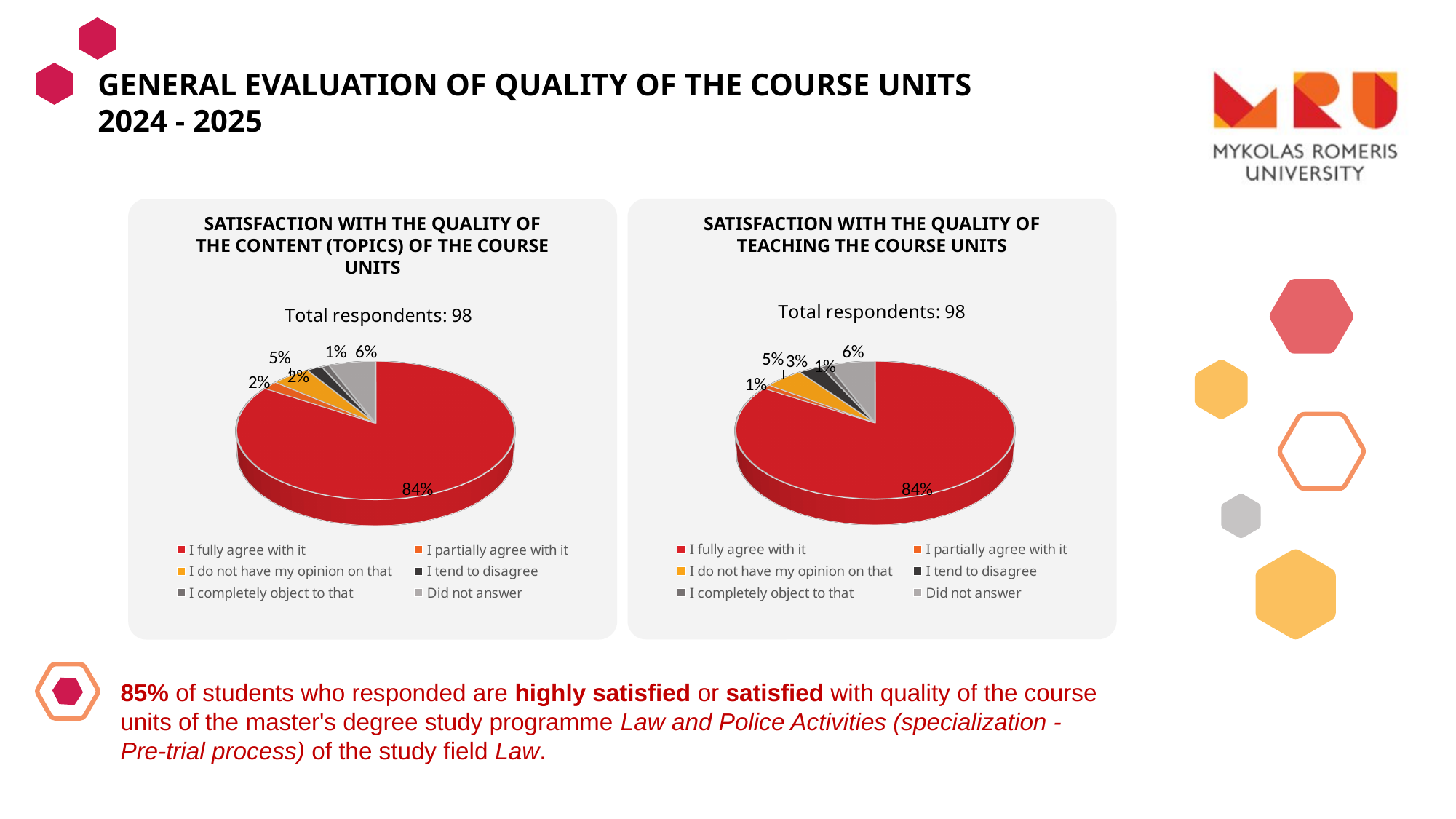
How many response categories does the legend of the 'Satisfaction with the quality of teaching the course units' chart list? 6 In the 'Satisfaction with the quality of the content (topics) of the course units' chart, what share of respondents chose 'I fully agree with it'? 84% What kind of chart is used in the 'Satisfaction with the quality of the content (topics) of the course units' panel? Pie chart In the 'Satisfaction with the quality of the content (topics) of the course units' chart, what percentage is shown for 'Did not answer'? 6% In the 'Satisfaction with the quality of teaching the course units' chart, what percentage is shown for 'I tend to disagree'? 3% In the 'Satisfaction with the quality of teaching the course units' chart, which is larger: 'Did not answer' or 'I tend to disagree'? Did not answer How many total respondents are reported for the 'Satisfaction with the quality of teaching the course units' chart? 98 In the 'Satisfaction with the quality of teaching the course units' chart, what share of respondents chose 'I fully agree with it'? 84% What colour is the 'I fully agree with it' slice in both pie charts? Red In the 'Satisfaction with the quality of teaching the course units' chart, what percentage is shown for 'I do not have my opinion on that'? 5% In the 'Satisfaction with the quality of the content (topics) of the course units' chart, which response category has the largest slice? I fully agree with it In the 'Satisfaction with the quality of the content (topics) of the course units' chart, how many percentage points larger is 'I fully agree with it' than 'Did not answer'? 78